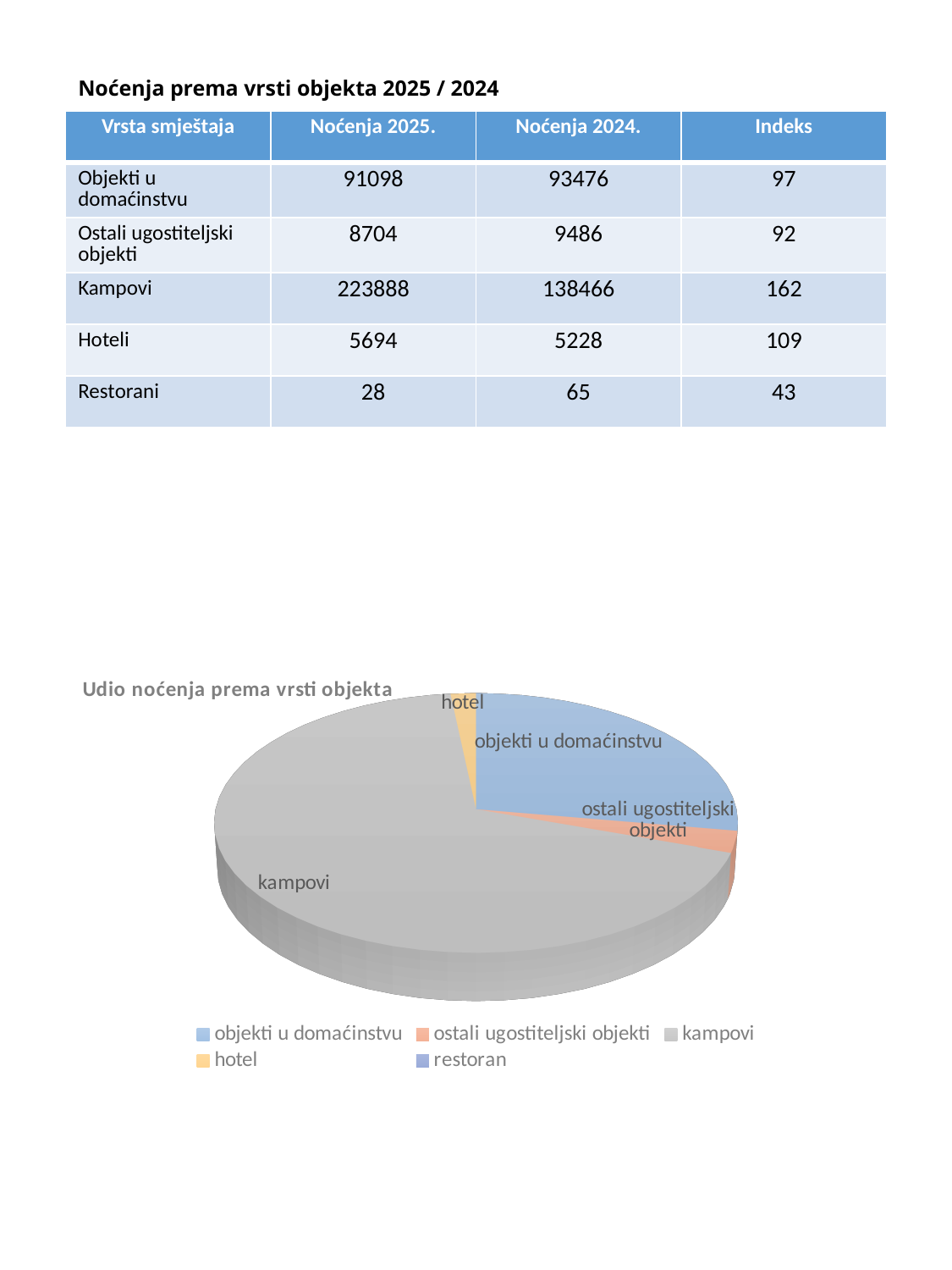
In the pie chart, which slice is larger: objekti u domaćinstvu or hotel? objekti u domaćinstvu What is the title of the pie chart? Udio noćenja prema vrsti objekta Which category has the largest slice in the pie chart? kampovi In the pie chart, which slice is larger: kampovi or objekti u domaćinstvu? kampovi In the pie chart, which slice is larger: hotel or kampovi? kampovi What kind of chart is shown on the slide? pie chart How many entries does the legend of the pie chart list? 5 Which category is shown in grey in the pie chart? kampovi